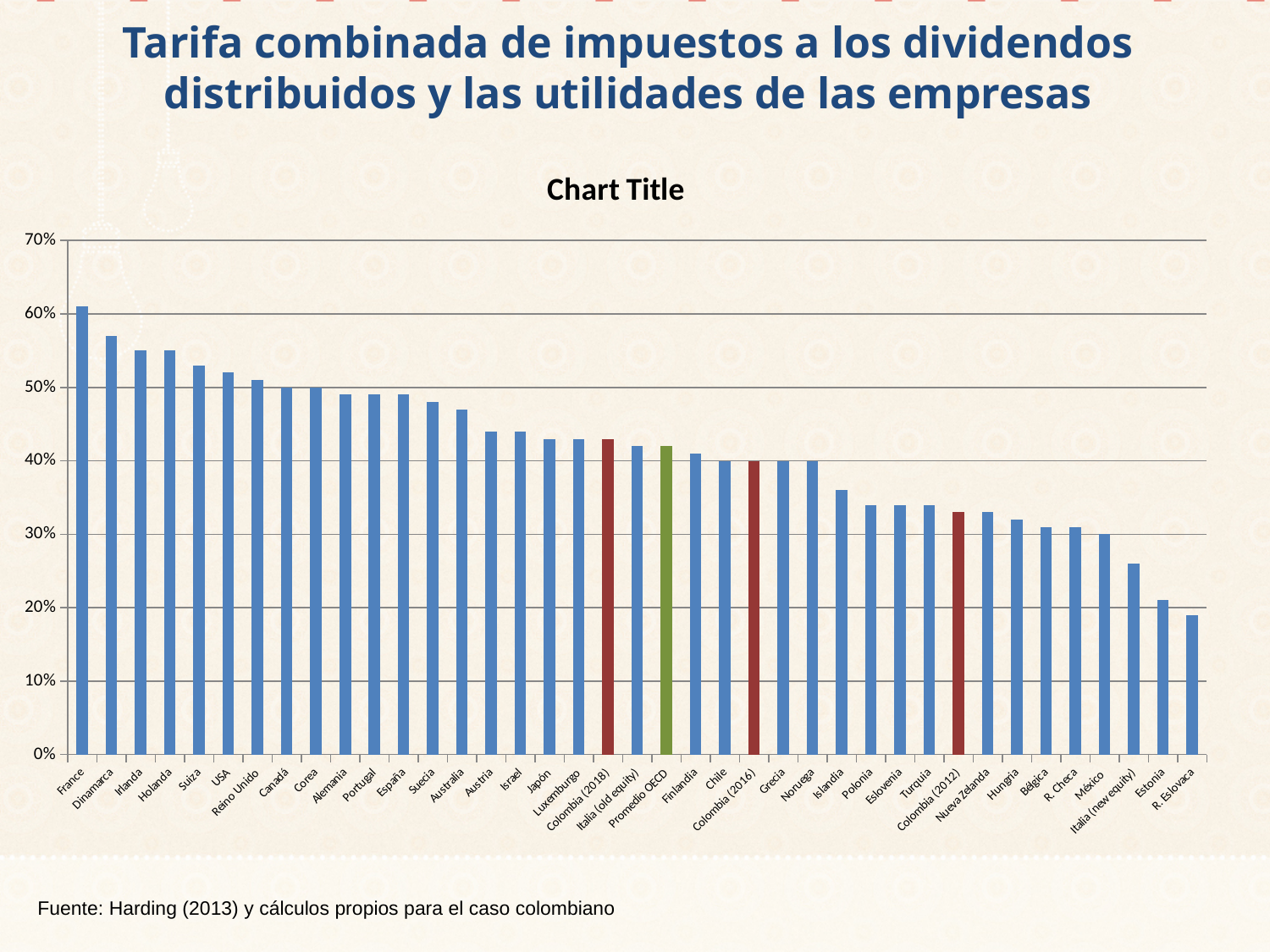
How many categories are plotted on the x axis? 39 Which category has the lowest value in the chart? R. Eslovaca Which country has the highest combined tax rate in the chart? France Is the value for Dinamarca greater or less than 60%? less Do the values generally rise or fall moving from left to right along the x axis? fall What colour is the bar for Promedio OECD? green Which is larger, the value for Suiza or the value for Estonia? Suiza Is the value for R. Eslovaca greater or less than 20%? less Is the value for Islandia greater or less than 30%? greater What kind of chart is shown on the slide? bar chart Which is larger, the value for Colombia (2018) or the value for Colombia (2012)? Colombia (2018)